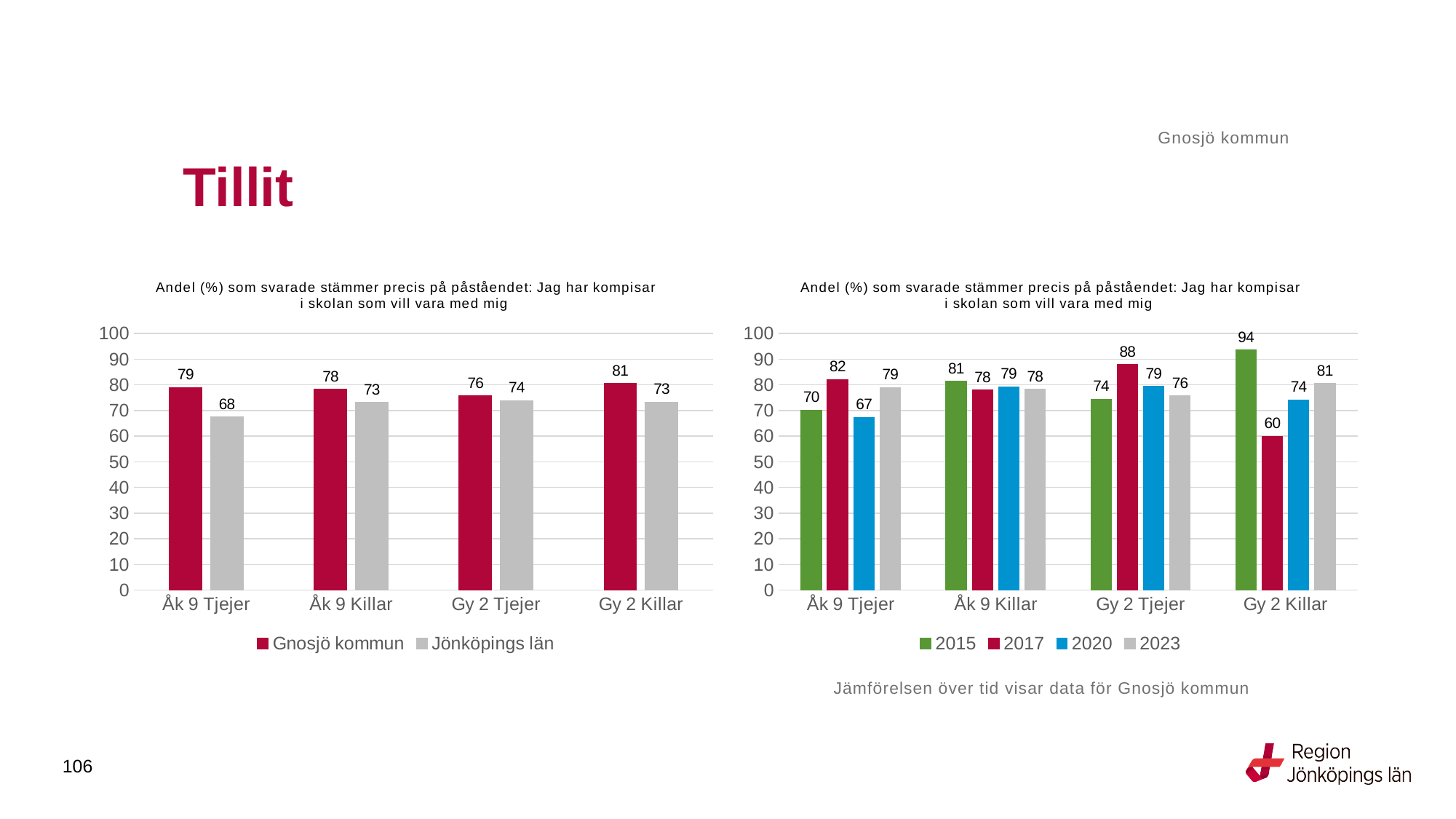
In the right chart, what is the value for 2015 for Gy 2 Killar? 94 In the left chart, what is the value for Jönköpings län for Gy 2 Tjejer? 74 In the right chart, which year has the lowest value for Gy 2 Killar? 2017 In the left chart, how many series does the legend list? 2 In the left chart, which category has the lowest value for Jönköpings län? Åk 9 Tjejer In the right chart, how many series does the legend list? 4 In the right chart, what is the difference between the 2015 and 2017 values for Gy 2 Killar? 34 In the right chart, which year has the highest value for Gy 2 Tjejer? 2017 What kind of chart is the left chart? Bar chart In the left chart, what is the difference between Gnosjö kommun and Jönköpings län for Åk 9 Tjejer? 11 In the right chart, what is the value for 2020 for Åk 9 Tjejer? 67 In the left chart, what is the value for Gnosjö kommun for Åk 9 Tjejer? 79